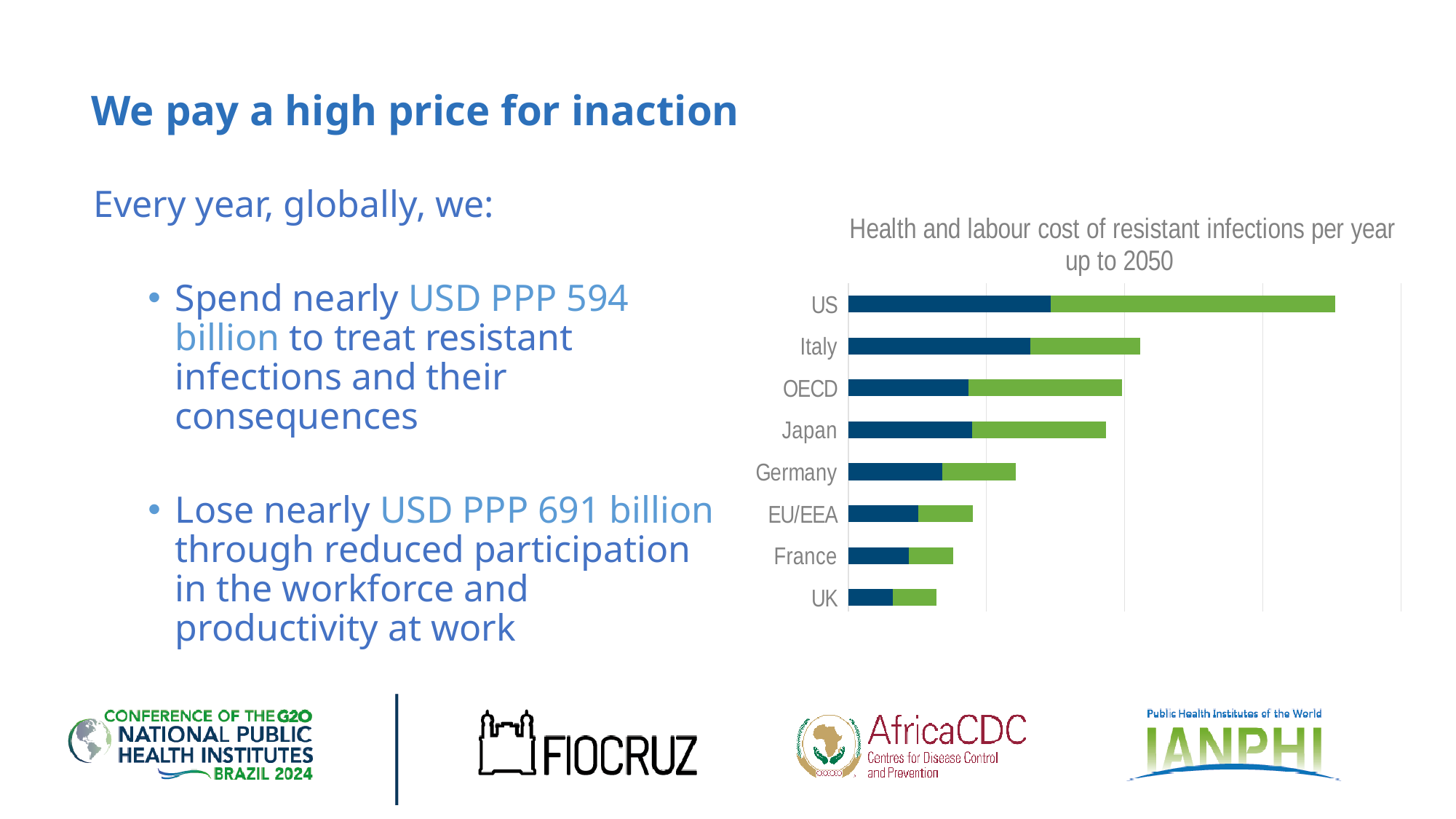
How many countries or regions are listed on the chart? 8 Which has a longer bar, Germany or EU/EEA? Germany Which has a longer bar, Japan or Germany? Japan Which has a longer bar, US or Italy? US Which country or region has the shortest bar in the chart? UK How many coloured segments make up each bar in the chart? 2 What kind of chart is shown on the slide? Stacked bar chart What is the title of the chart? Health and labour cost of resistant infections per year up to 2050 Do the bar lengths increase or decrease going from the top category (US) to the bottom category (UK)? Decrease Which country or region has the longest bar in the chart? US